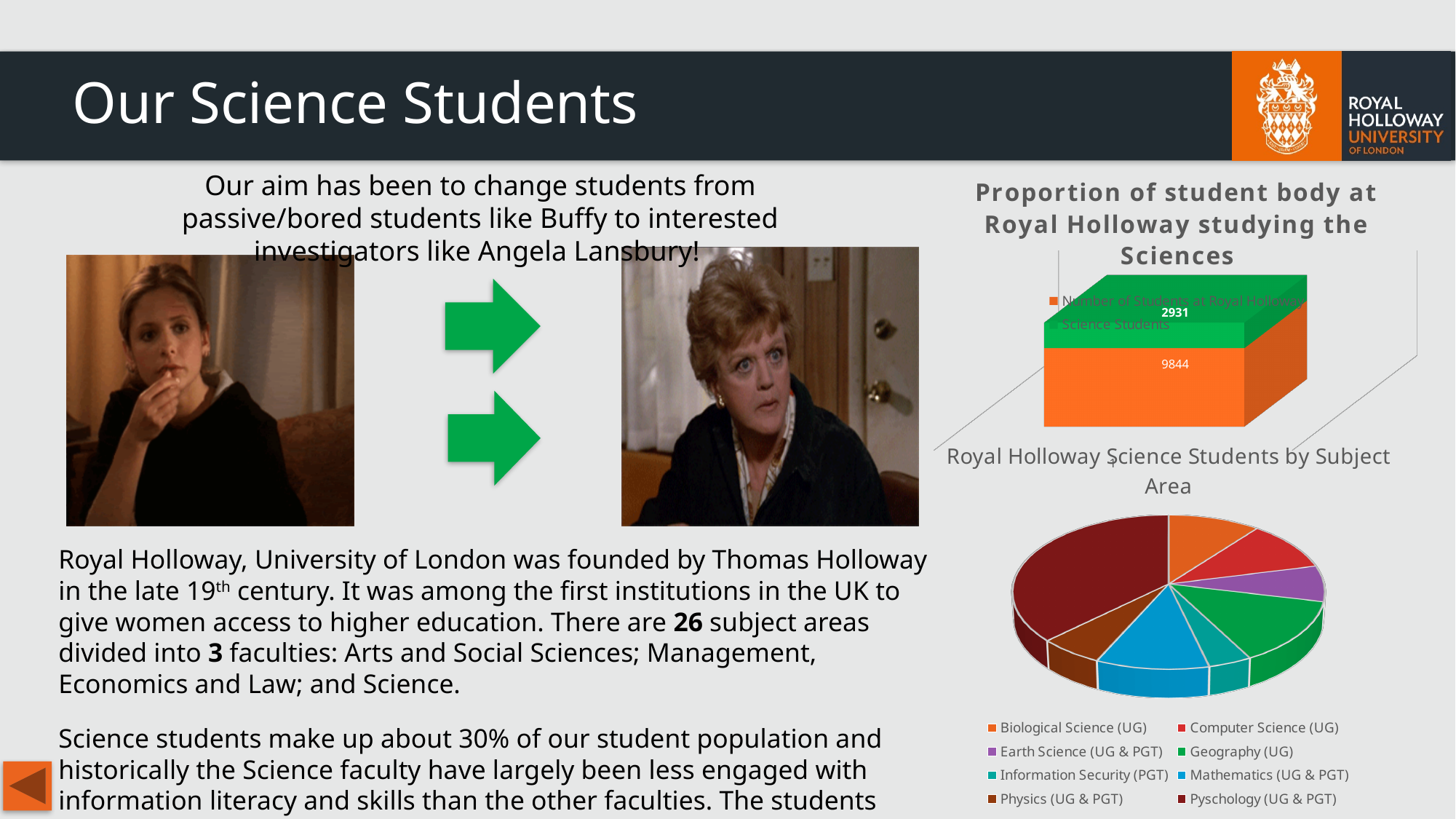
On the chart titled 'Royal Holloway Science Students by Subject Area', what colour represents Biological Science (UG)? Orange On the chart titled 'Proportion of student body at Royal Holloway studying the Sciences', what value is shown for Number of Students at Royal Holloway? 9844 On the chart titled 'Royal Holloway Science Students by Subject Area', which slice is larger: Mathematics (UG & PGT) or Earth Science (UG & PGT)? Mathematics (UG & PGT) On the chart titled 'Proportion of student body at Royal Holloway studying the Sciences', what is the total of the two stacked segments? 12775 On the chart titled 'Proportion of student body at Royal Holloway studying the Sciences', which is larger: Number of Students at Royal Holloway or Science Students? Number of Students at Royal Holloway On the chart titled 'Proportion of student body at Royal Holloway studying the Sciences', what value is shown for Science Students? 2931 What kind of chart is the one titled 'Proportion of student body at Royal Holloway studying the Sciences'? Bar chart On the chart titled 'Royal Holloway Science Students by Subject Area', which subject area has the largest slice? Pyschology (UG & PGT) How many subject areas are listed in the legend of the chart titled 'Royal Holloway Science Students by Subject Area'? 8 On the chart titled 'Proportion of student body at Royal Holloway studying the Sciences', what is the difference between the Number of Students at Royal Holloway and the Science Students values? 6913 What kind of chart is the one titled 'Royal Holloway Science Students by Subject Area'? Pie chart How many series does the legend list on the chart titled 'Proportion of student body at Royal Holloway studying the Sciences'? 2